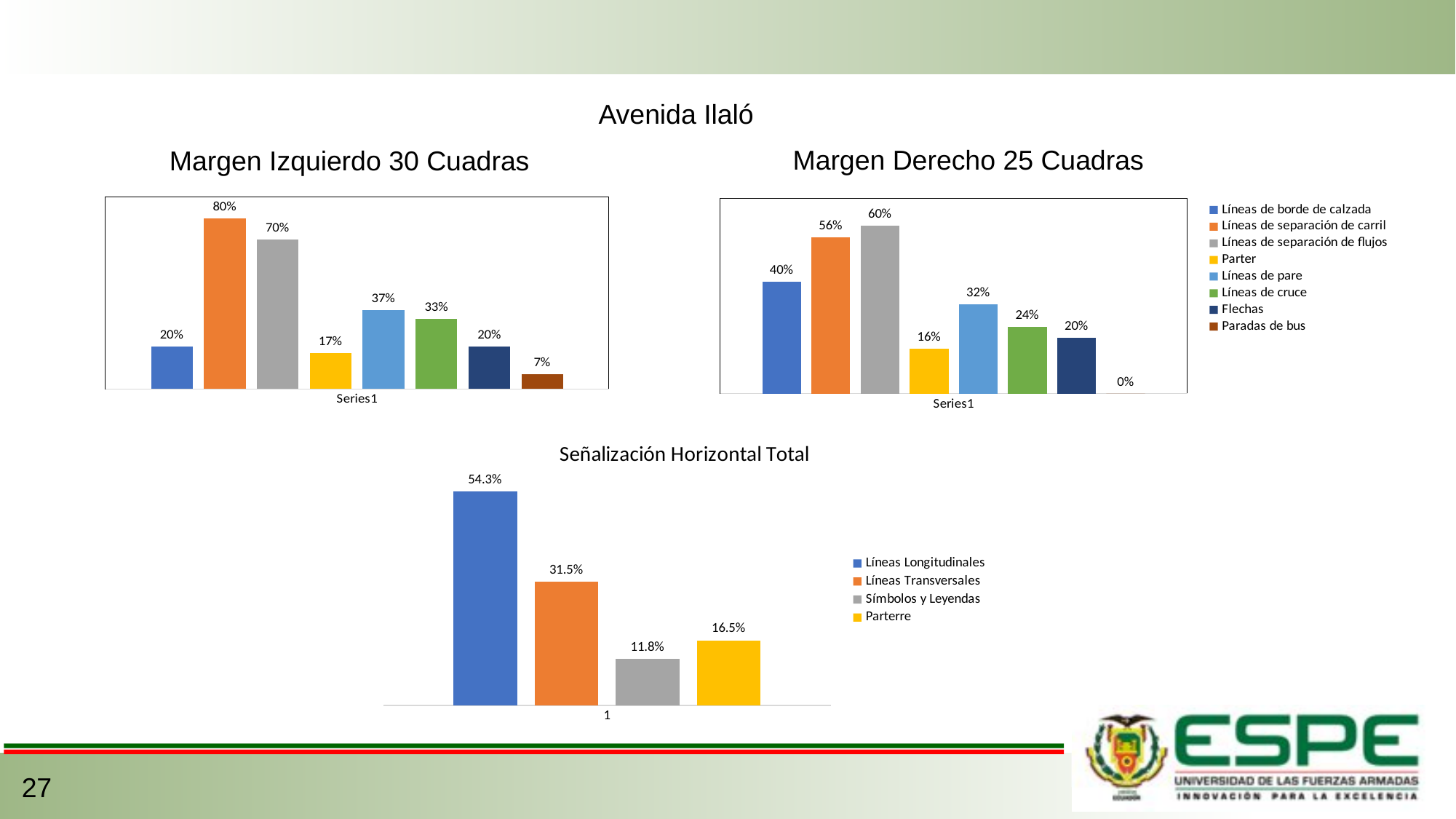
In the 'Margen Derecho 25 Cuadras' chart, which is larger: Líneas de pare or Líneas de cruce? Líneas de pare In the 'Margen Izquierdo 30 Cuadras' chart, what is the value for Líneas de separación de carril? 80% What kind of chart is the 'Señalización Horizontal Total' chart? Bar chart In the 'Margen Izquierdo 30 Cuadras' chart, which series has the lowest value? Paradas de bus In the 'Margen Derecho 25 Cuadras' chart, which series has the highest value? Líneas de separación de flujos In the 'Señalización Horizontal Total' chart, what is the difference between Líneas Transversales and Parterre? 15.0% In the 'Señalización Horizontal Total' chart, which series has the lowest value? Símbolos y Leyendas In the 'Margen Derecho 25 Cuadras' chart, what is the value for Líneas de borde de calzada? 40% In the 'Margen Izquierdo 30 Cuadras' chart, what is the difference between Líneas de pare and Líneas de cruce? 4% In the 'Señalización Horizontal Total' chart, what is the value for Líneas Longitudinales? 54.3% How many series does the legend of the 'Margen Derecho 25 Cuadras' chart list? 8 In the 'Margen Derecho 25 Cuadras' chart, what is the value for Paradas de bus? 0%